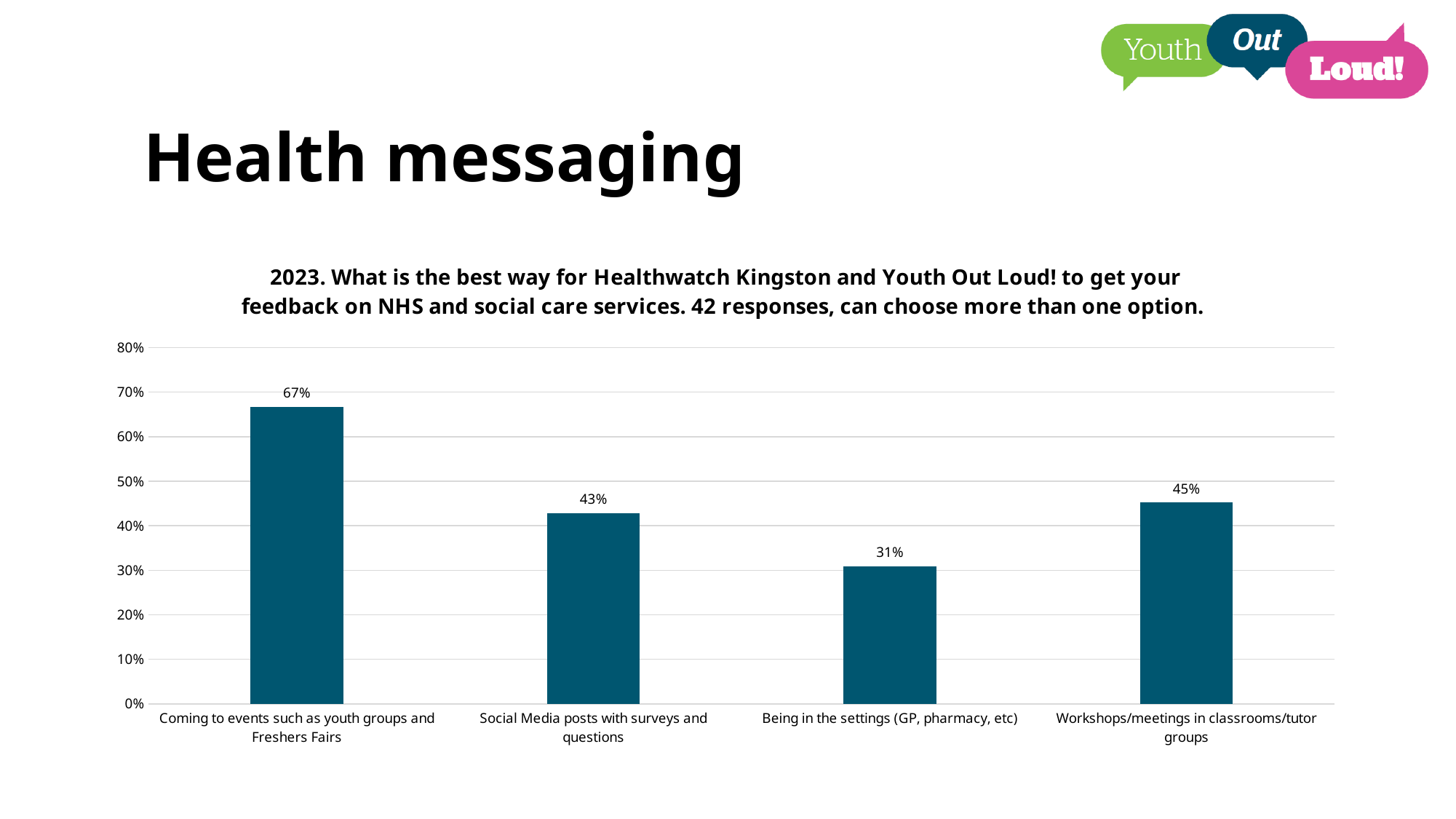
What is the difference in percentage points between 'Coming to events such as youth groups and Freshers Fairs' and 'Being in the settings (GP, pharmacy, etc)'? 36 percentage points How many options (categories) are shown in the chart? 4 Which option has the lowest percentage? Being in the settings (GP, pharmacy, etc) How many responses does the chart title say were received? 42 What kind of chart is shown on the slide? Bar chart Which is larger: the value for 'Social Media posts with surveys and questions' or for 'Workshops/meetings in classrooms/tutor groups'? Workshops/meetings in classrooms/tutor groups What percentage of respondents chose 'Coming to events such as youth groups and Freshers Fairs'? 67% What is the value for 'Workshops/meetings in classrooms/tutor groups'? 45% Is the value for 'Being in the settings (GP, pharmacy, etc)' greater or less than 40%? less What is the value for 'Being in the settings (GP, pharmacy, etc)'? 31% Which option has the highest percentage? Coming to events such as youth groups and Freshers Fairs What is the value for 'Social Media posts with surveys and questions'? 43%